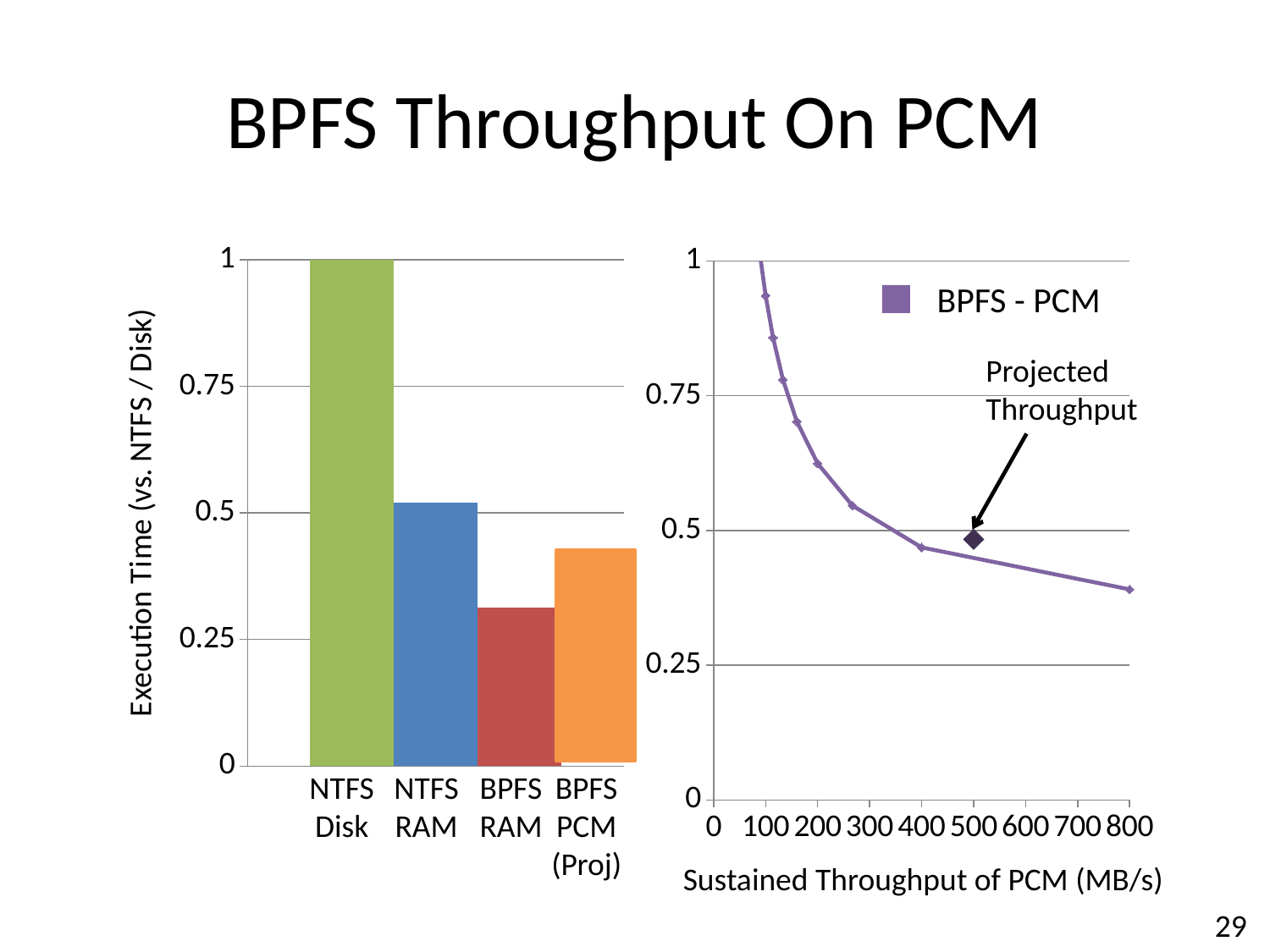
In the left bar chart, how many categories are shown on the x axis? 4 In the left bar chart, which category has the lowest execution time? BPFS RAM In the right line chart, is the BPFS - PCM value at 800 MB/s greater or less than 0.5? less What is the x-axis label of the right line chart? Sustained Throughput of PCM (MB/s) What kind of chart is the left chart on the slide? bar chart In the left bar chart, what is the execution time value for NTFS Disk? 1 In the right line chart, does the BPFS - PCM line rise or fall as sustained throughput increases? fall In the left bar chart, which is larger, the value for NTFS RAM or the value for BPFS RAM? NTFS RAM In the left bar chart, is the value for NTFS RAM greater or less than 0.75? less In the left bar chart, which category has the highest execution time? NTFS Disk What kind of chart is the right chart on the slide? line chart In the left bar chart, is the value for BPFS PCM (Proj) greater or less than 0.25? greater